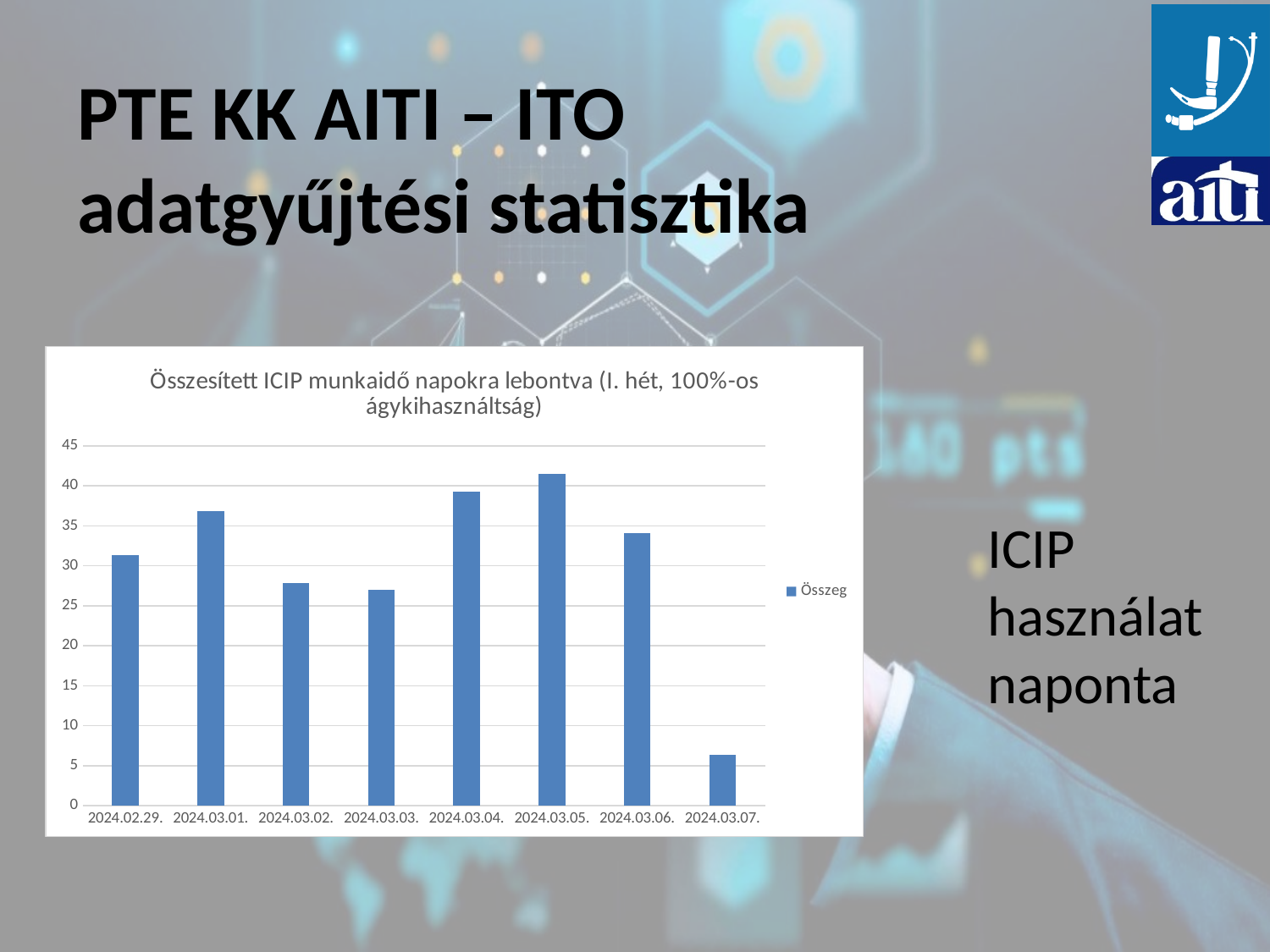
What kind of chart is shown on the slide? bar chart Which is larger, the value for 2024.03.01. or the value for 2024.03.06.? 2024.03.01. Is the value for 2024.03.05. greater or less than 40? greater What is the title of the chart? Összesített ICIP munkaidő napokra lebontva (I. hét, 100%-os ágykihasználtság) How many series does the legend list? 1 How many dates are shown on the x axis? 8 What is the name of the series in the legend? Összeg Is the value for 2024.02.29. greater or less than 30? greater Which date has the lowest value? 2024.03.07. Is the value for 2024.03.07. greater or less than 10? less Which date has the highest value? 2024.03.05.